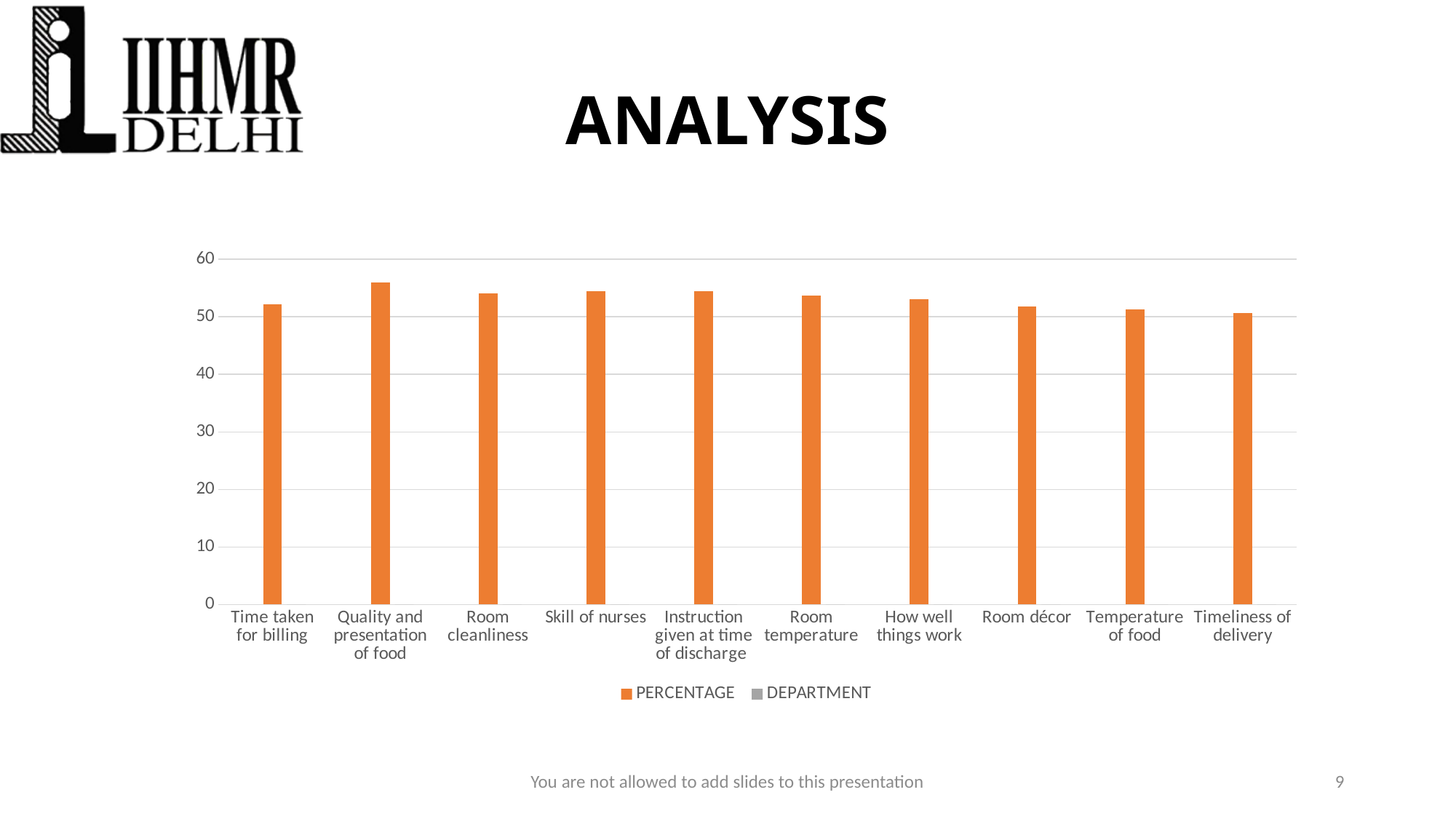
How many series does the chart's legend list? 2 Which category has the highest bar in the chart? Quality and presentation of food Which is larger, the value for Room cleanliness or the value for Timeliness of delivery? Room cleanliness Is the value for Quality and presentation of food greater or less than 50? greater Is the value for Time taken for billing greater or less than 60? less Which is larger, the value for Quality and presentation of food or the value for Time taken for billing? Quality and presentation of food What colour are the bars for the PERCENTAGE series? Orange What are the two series names listed in the chart's legend? PERCENTAGE and DEPARTMENT Is the value for Room décor greater or less than 40? greater How many categories are shown on the x axis of the chart? 10 What kind of chart is shown on the slide? Bar chart